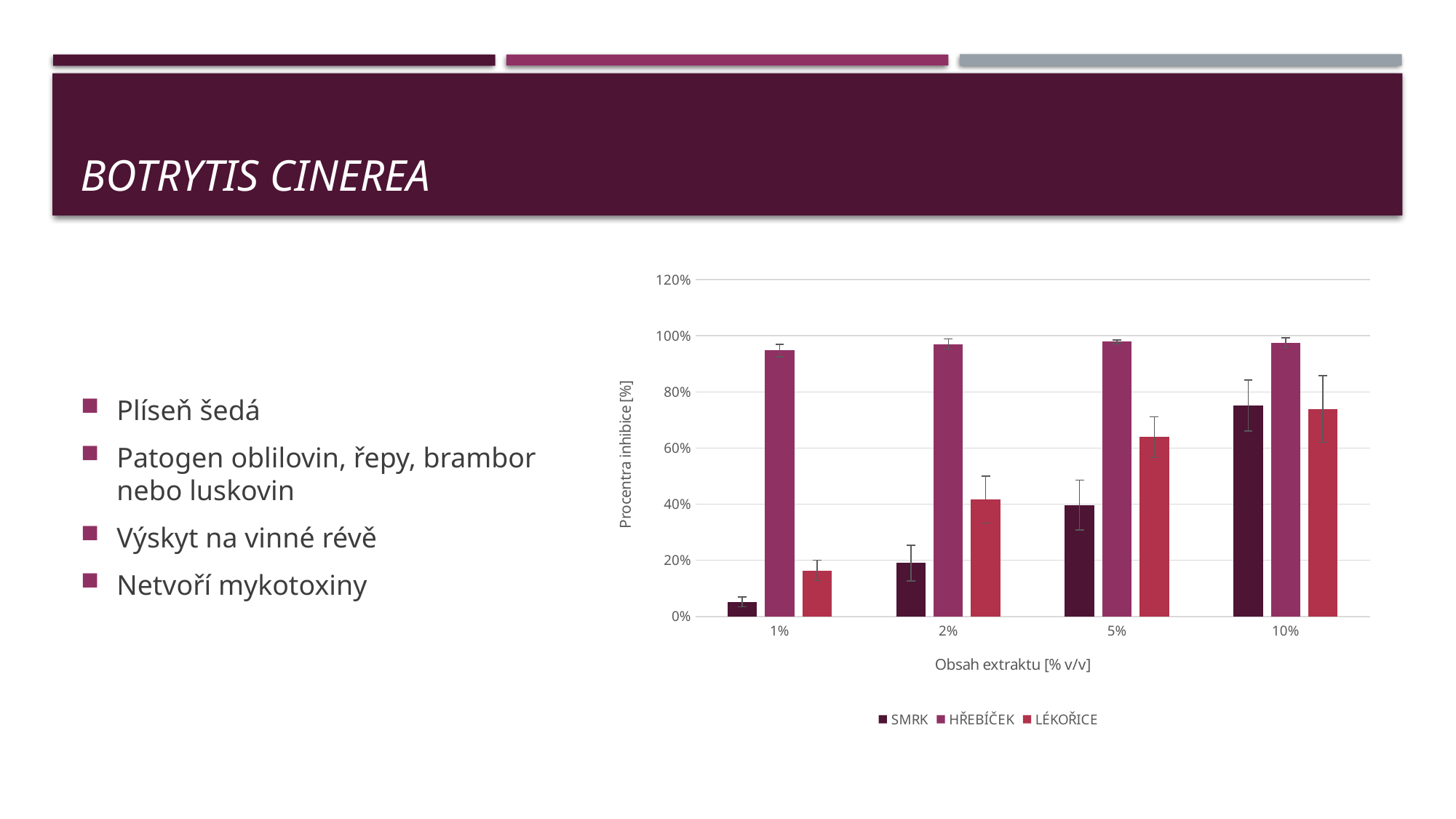
Is the value for SMRK at 5% extract content greater or less than 60%? less Is the value for SMRK at 1% extract content greater or less than 20%? less Which series has the highest inhibition at 1% extract content? HŘEBÍČEK What kind of chart is shown on the slide? bar chart Which series has the lowest inhibition at 2% extract content? SMRK Do the SMRK values rise or fall as the extract content increases from 1% to 10%? rise Is the value for HŘEBÍČEK at 10% extract content greater or less than 80%? greater What is the label of the y axis? Procentra inhibice [%] Which is larger at 2% extract content: SMRK or LÉKOŘICE? LÉKOŘICE How many extract concentration categories are shown on the x axis? 4 How many series does the legend list? 3